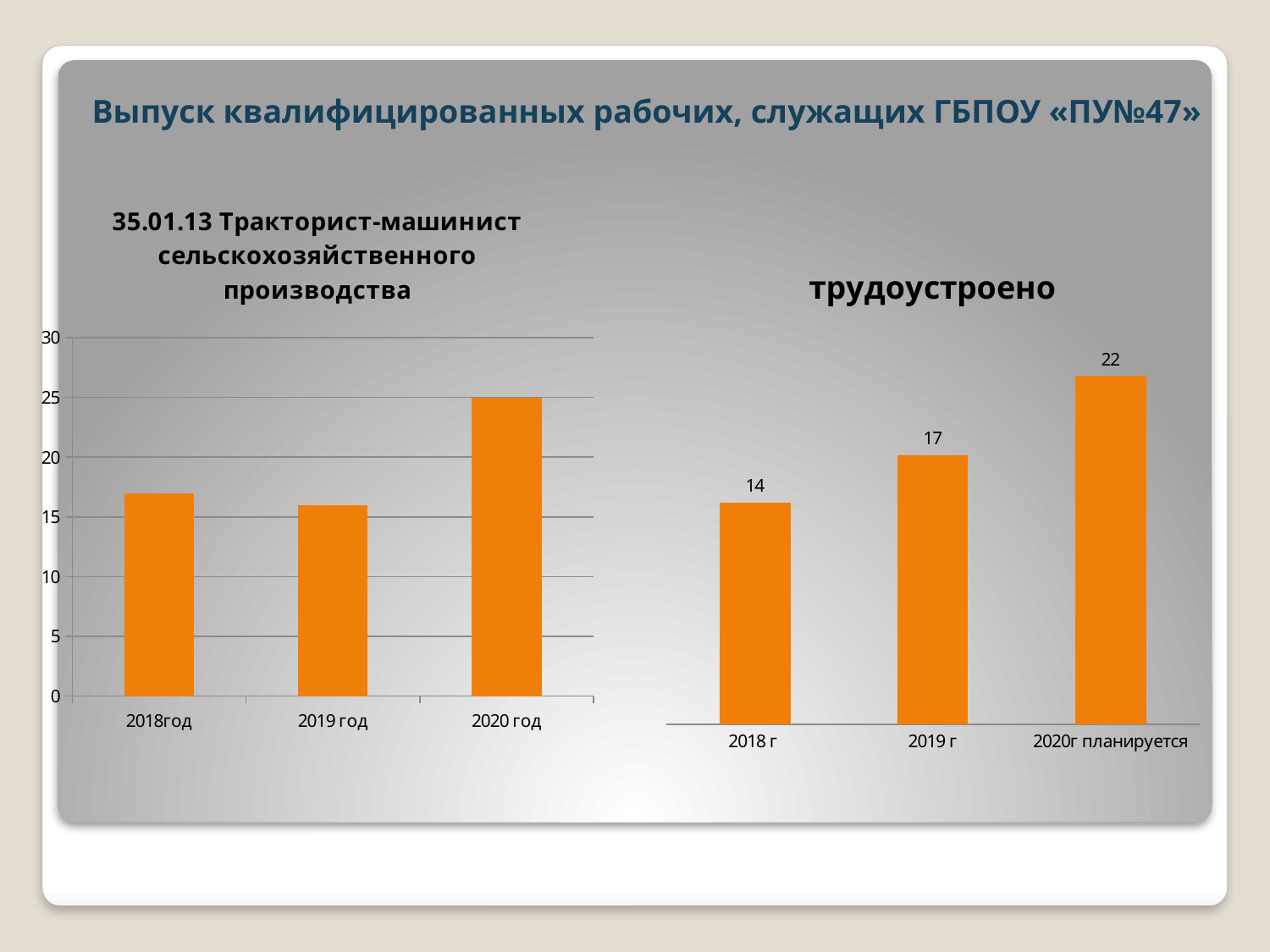
On the left chart titled «35.01.13 Тракторист-машинист сельскохозяйственного производства», is the value for 2018год greater or less than 15? greater On the chart titled «трудоустроено», which category has the lowest value? 2018 г On the chart titled «трудоустроено», what is the difference between the values for 2020г планируется and 2018 г? 8 On the chart titled «трудоустроено», what is the value for 2020г планируется? 22 On the chart titled «трудоустроено», do the values rise or fall from 2018 г to 2020г планируется? rise On the chart titled «трудоустроено», which category has the highest value? 2020г планируется On the chart titled «трудоустроено», what is the value for 2018 г? 14 On the chart titled «трудоустроено», what is the value for 2019 г? 17 What kind of chart is the chart titled «трудоустроено»? bar chart On the left chart titled «35.01.13 Тракторист-машинист сельскохозяйственного производства», how many categories are shown on the x axis? 3 On the left chart titled «35.01.13 Тракторист-машинист сельскохозяйственного производства», which category has the highest value? 2020 год On the left chart titled «35.01.13 Тракторист-машинист сельскохозяйственного производства», what is the value for 2020 год? 25